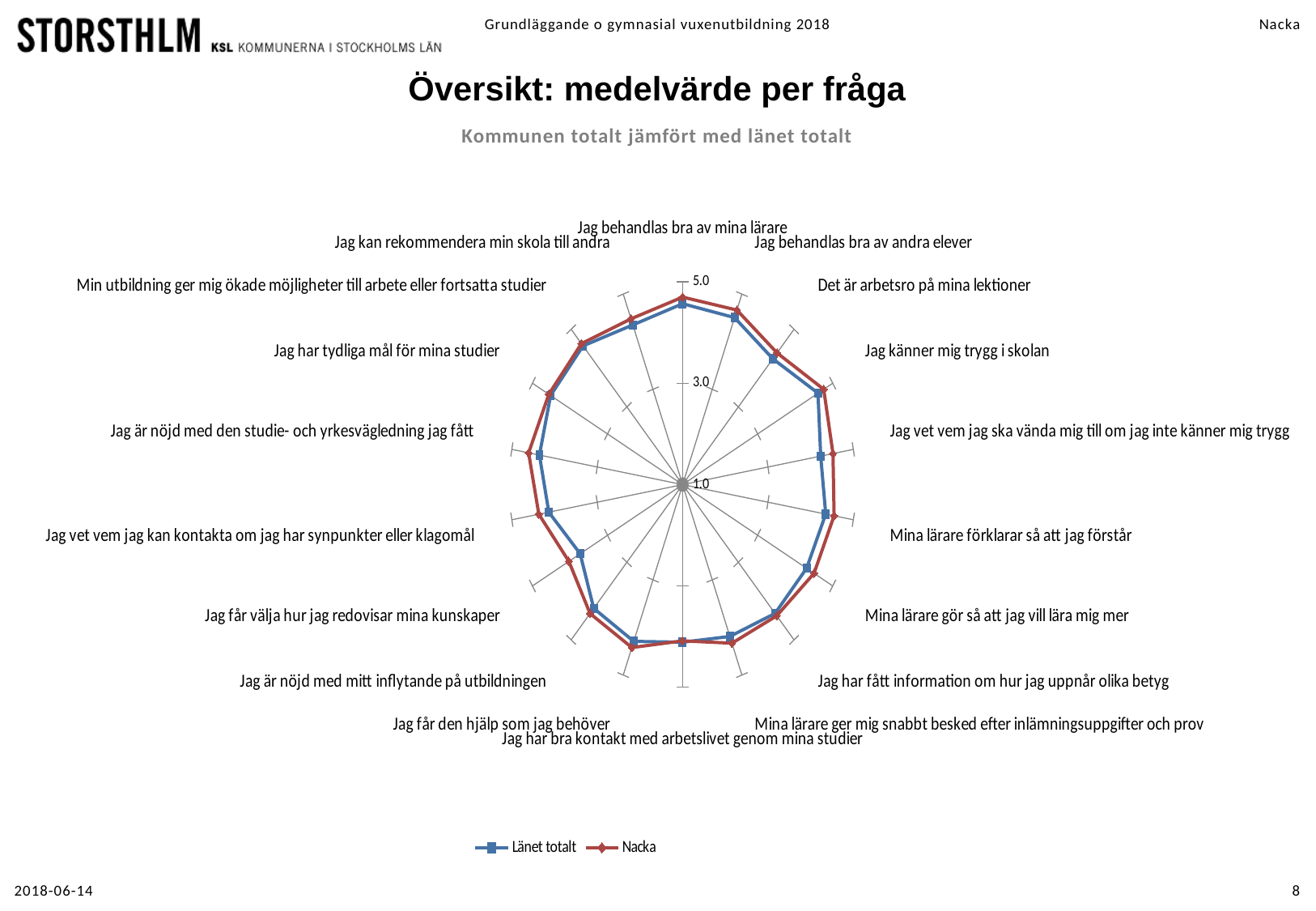
How many questions (categories) are plotted around the radar chart? 18 What is the title of the chart? Översikt: medelvärde per fråga Is the Nacka value for 'Jag behandlas bra av mina lärare' greater or less than 3.0? greater For 'Jag vet vem jag kan kontakta om jag har synpunkter eller klagomål', which series has the higher value, Nacka or Länet totalt? Nacka Is the Länet totalt value for 'Jag får välja hur jag redovisar mina kunskaper' greater or less than 3.0? greater For 'Jag är nöjd med den studie- och yrkesvägledning jag fått', which series has the higher value, Nacka or Länet totalt? Nacka Is the Nacka value for 'Jag känner mig trygg i skolan' greater or less than 3.0? greater What kind of chart is shown on the slide? Radar chart How many series does the legend list? 2 Which two series are listed in the legend? Länet totalt and Nacka